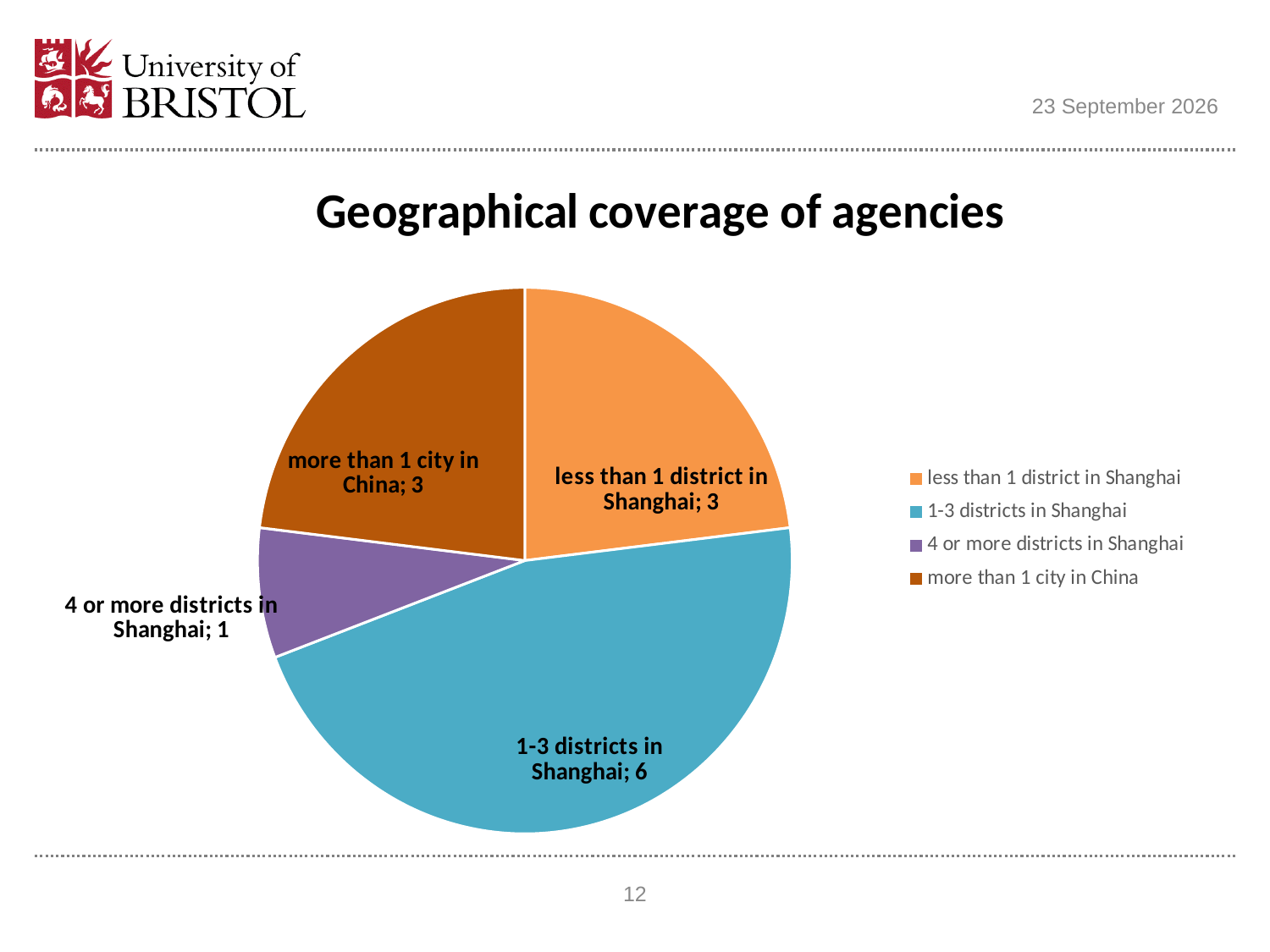
Which category has the smallest slice of the pie? 4 or more districts in Shanghai What is the difference between the values for '1-3 districts in Shanghai' and '4 or more districts in Shanghai'? 5 What type of chart is shown on the slide? pie chart What colour is the '1-3 districts in Shanghai' slice? blue What is the value for the '4 or more districts in Shanghai' slice? 1 What is the value for the 'more than 1 city in China' slice? 3 How many agencies cover 1-3 districts in Shanghai? 6 What is the value for the 'less than 1 district in Shanghai' slice? 3 How many categories does the pie chart have? 4 Which category has the largest slice of the pie? 1-3 districts in Shanghai What is the title of the chart? Geographical coverage of agencies Which is larger: the value for '1-3 districts in Shanghai' or for 'more than 1 city in China'? 1-3 districts in Shanghai